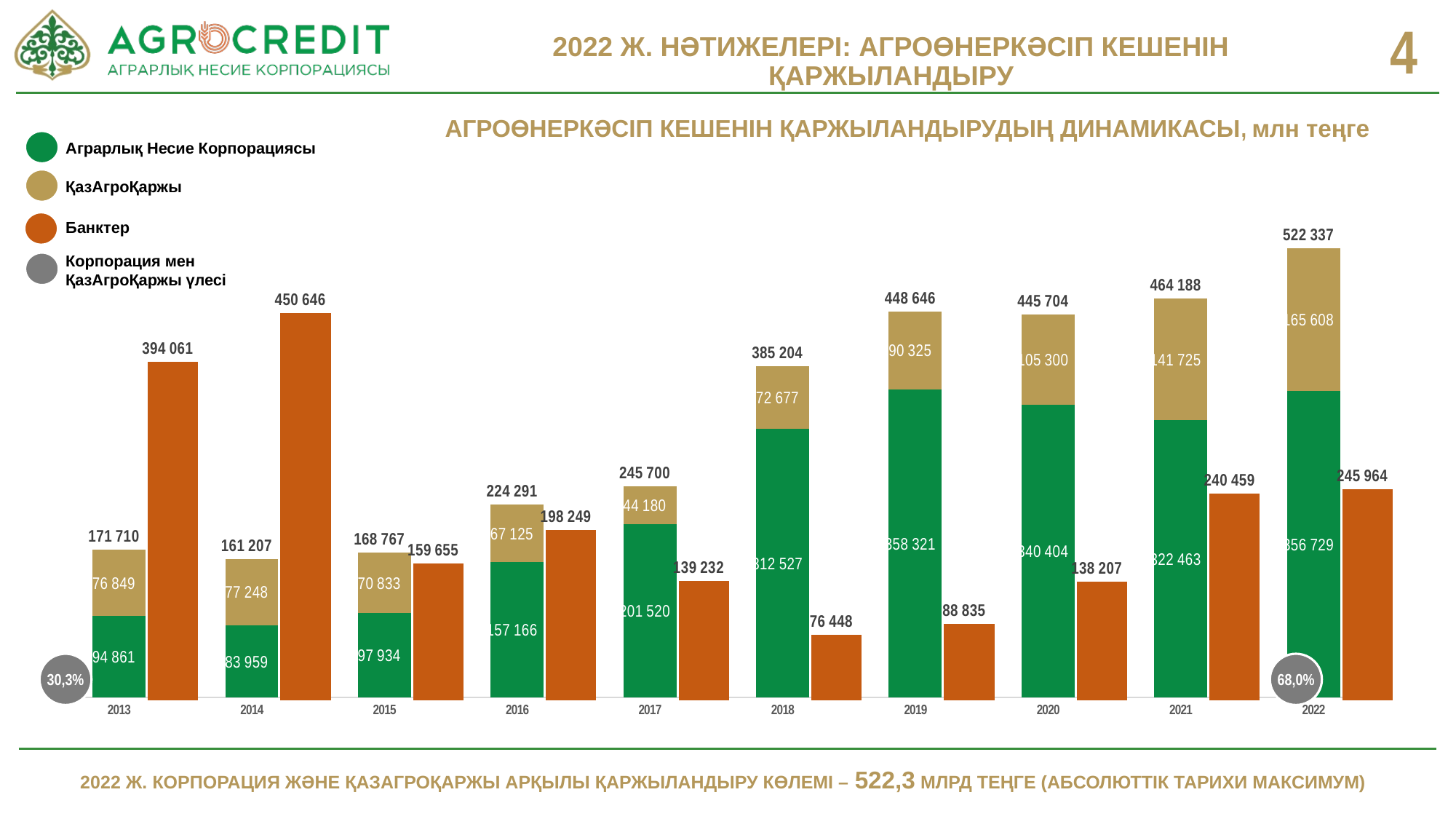
What is the total of the stacked bar (Аграрлық Несие Корпорациясы plus ҚазАгроҚаржы) for 2019? 448 646 What type of chart is shown on the slide? bar chart What is the value for Банктер in 2014? 450 646 How many years are shown along the x axis of the chart? 10 How many entries does the legend list? 4 What share of financing is shown in the grey circle for 2022 (Корпорация мен ҚазАгроҚаржы үлесі)? 68,0% In which year is the Банктер value lowest? 2018 In which year is the stacked total of Аграрлық Несие Корпорациясы and ҚазАгроҚаржы highest? 2022 Which is larger in 2016: the stacked total of the Corporation and ҚазАгроҚаржы, or the Банктер value? the stacked total (224 291) What is the difference between the Банктер value in 2022 and in 2021? 5 505 What is the value for ҚазАгроҚаржы in 2022? 165 608 What is the value for Аграрлық Несие Корпорациясы in 2018? 312 527